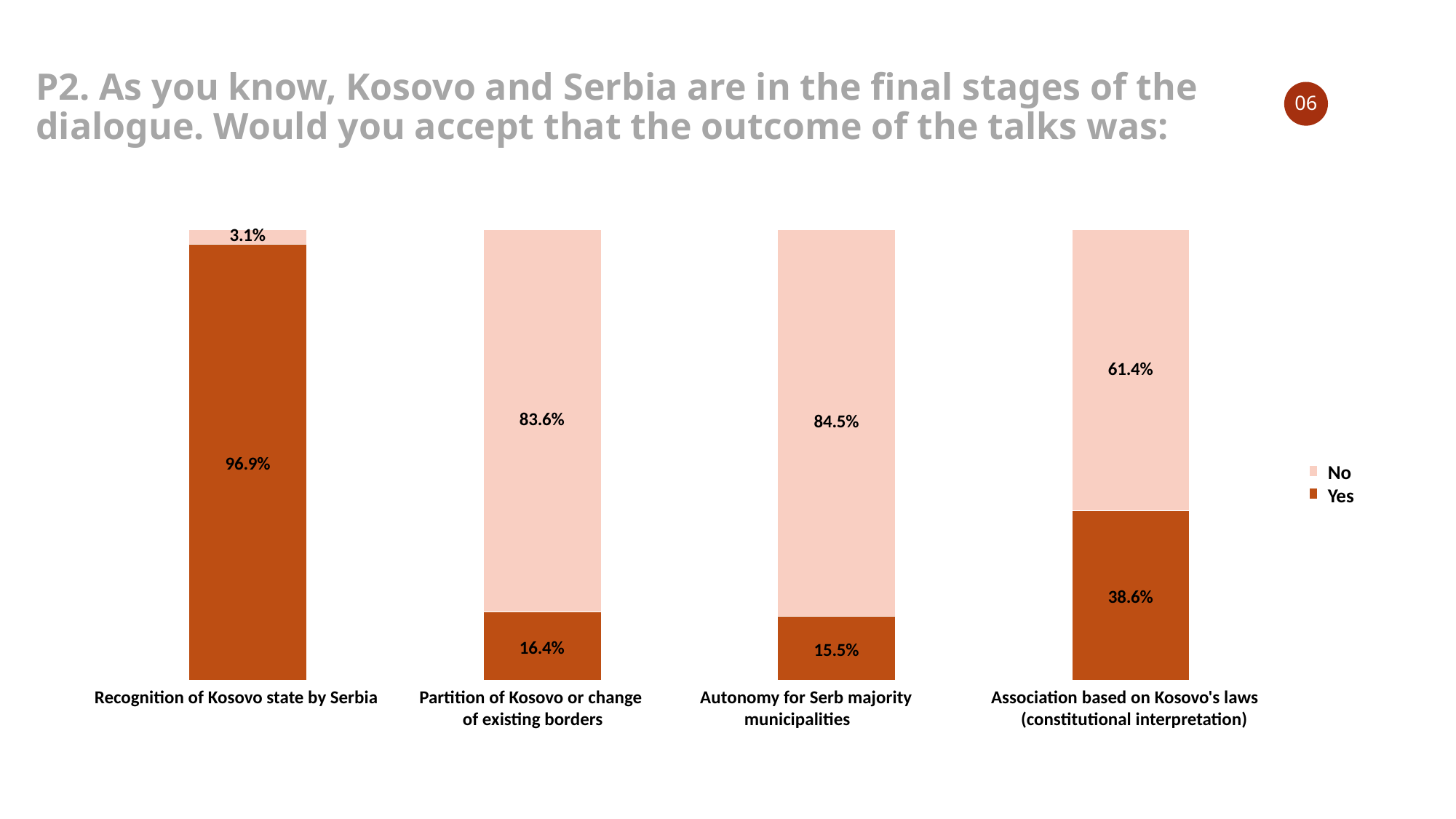
What is the No value for Association based on Kosovo's laws (constitutional interpretation)? 61.4% What is the Yes value for Autonomy for Serb majority municipalities? 15.5% Which legend entry is shown in the dark orange colour? Yes What is the difference between the No and Yes values for Association based on Kosovo's laws (constitutional interpretation)? 22.8% Which outcome has the highest Yes share? Recognition of Kosovo state by Serbia What kind of chart is shown on the slide? Stacked bar chart Which is larger: the Yes value for Partition of Kosovo or change of existing borders, or the Yes value for Association based on Kosovo's laws? Association based on Kosovo's laws What percentage answered No for Partition of Kosovo or change of existing borders? 83.6% How many outcome categories are shown on the x axis? 4 What percentage answered Yes for Recognition of Kosovo state by Serbia? 96.9% Which outcome has the lowest Yes share? Autonomy for Serb majority municipalities How many series does the legend list? 2